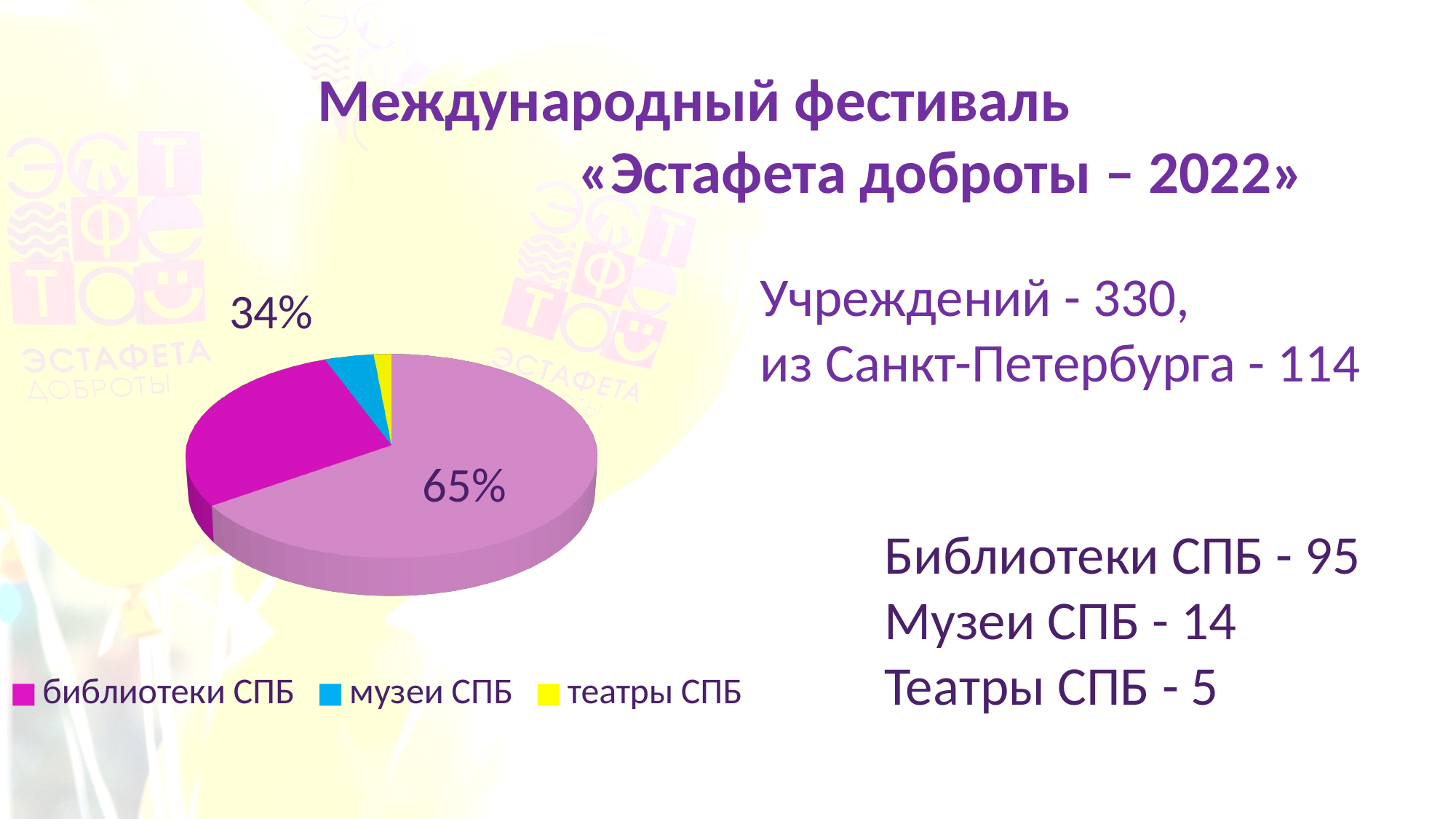
What kind of chart is shown on the slide? pie chart Which legend category has the smallest slice of the pie? театры СПБ What colour represents театры СПБ in the chart? yellow Which slice is larger, библиотеки СПБ or музеи СПБ? библиотеки СПБ Which slice is larger, музеи СПБ or театры СПБ? музеи СПБ How many entries does the chart legend list? 3 Which of the legend categories has the largest slice of the pie? библиотеки СПБ How many slices does the pie chart have? 4 What percentage label is printed on the largest slice of the pie? 65% Which two percentage labels are printed on the pie chart? 34% and 65% What colour represents библиотеки СПБ in the chart? magenta